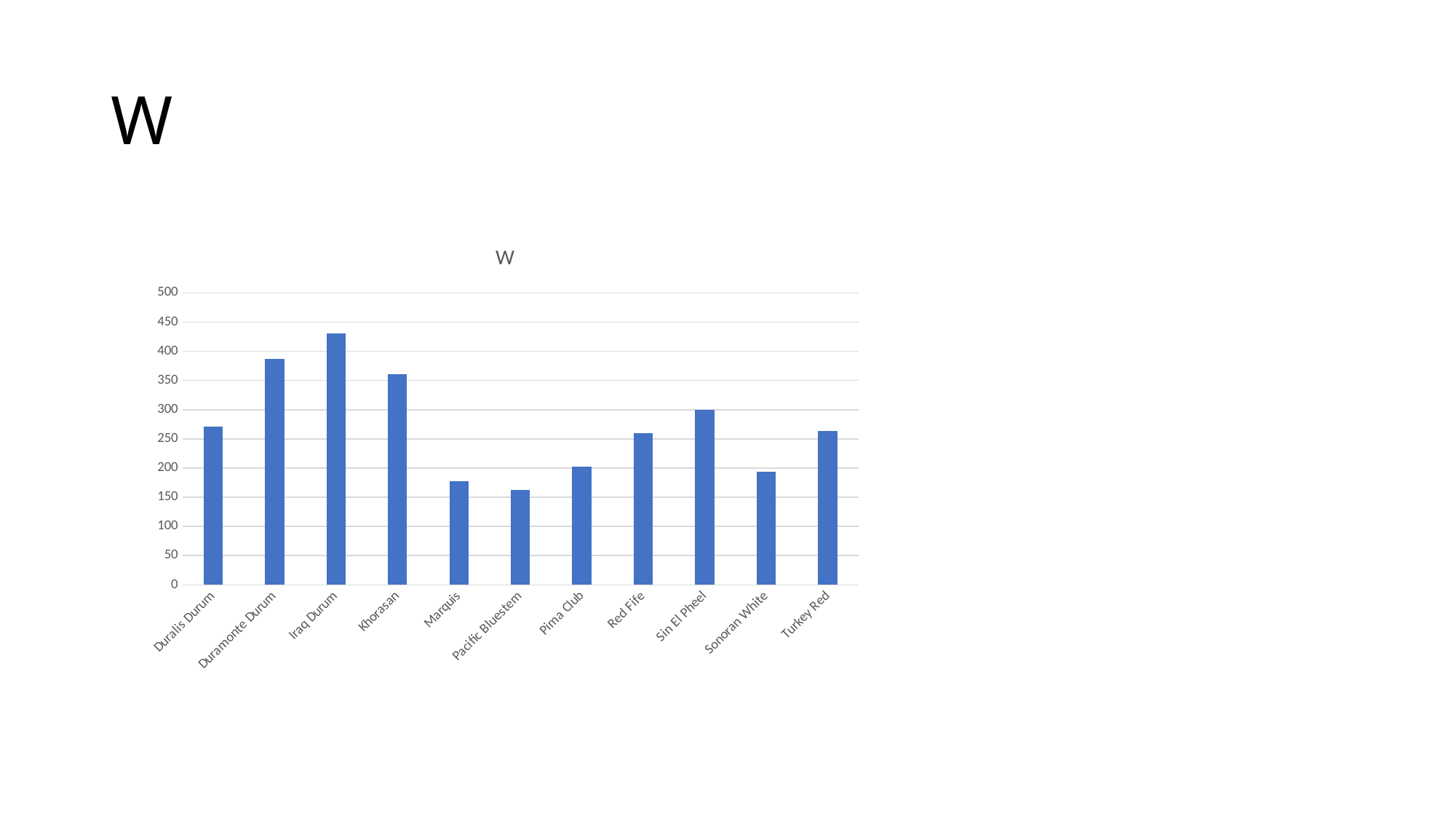
Is the value for Iraq Durum greater or less than 400? greater What is the title of the chart? W How many categories are plotted on the chart? 11 Which is larger, the value for Khorasan or the value for Sin El Pheel? Khorasan Is the value for Khorasan greater or less than 350? greater Is the value for Marquis greater or less than 200? less Which category has the lowest value? Pacific Bluestem Which category has the highest value? Iraq Durum Which is larger, the value for Pima Club or the value for Red Fife? Red Fife What kind of chart is shown on the slide? bar chart